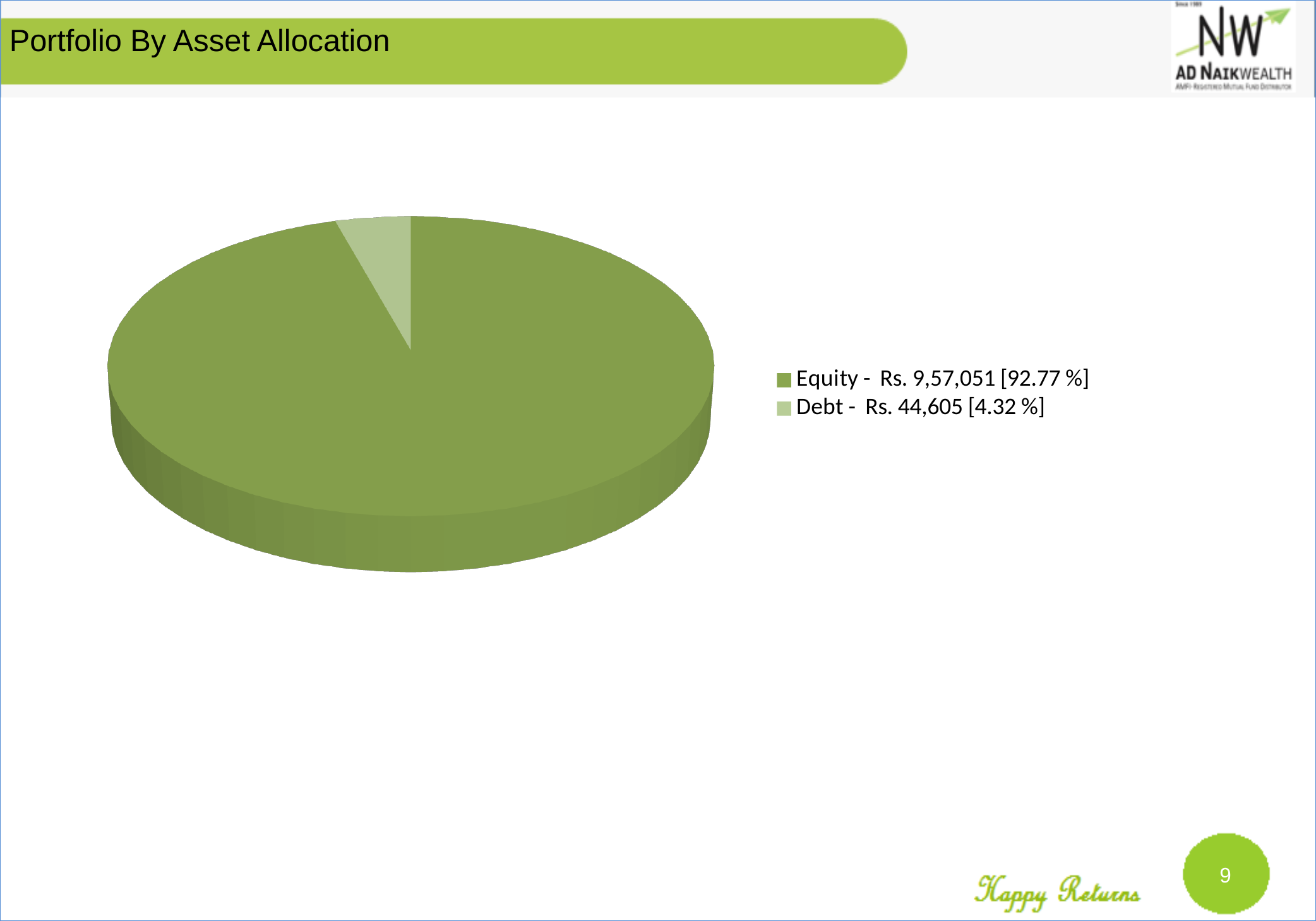
Which is larger, the value for Equity or the value for Debt? Equity What is the title of the slide's chart? Portfolio By Asset Allocation What share of the pie does Equity represent? 92.77 % Which category has the largest slice of the pie? Equity How many entries does the legend list? 2 What is the difference between the Equity value and the Debt value? Rs. 9,12,446 What kind of chart is shown on the slide? Pie chart Which category has the smallest slice of the pie? Debt What share of the pie does Debt represent? 4.32 % What is the value for Equity? Rs. 9,57,051 What is the value for Debt? Rs. 44,605 How many slices does the pie chart have? 2